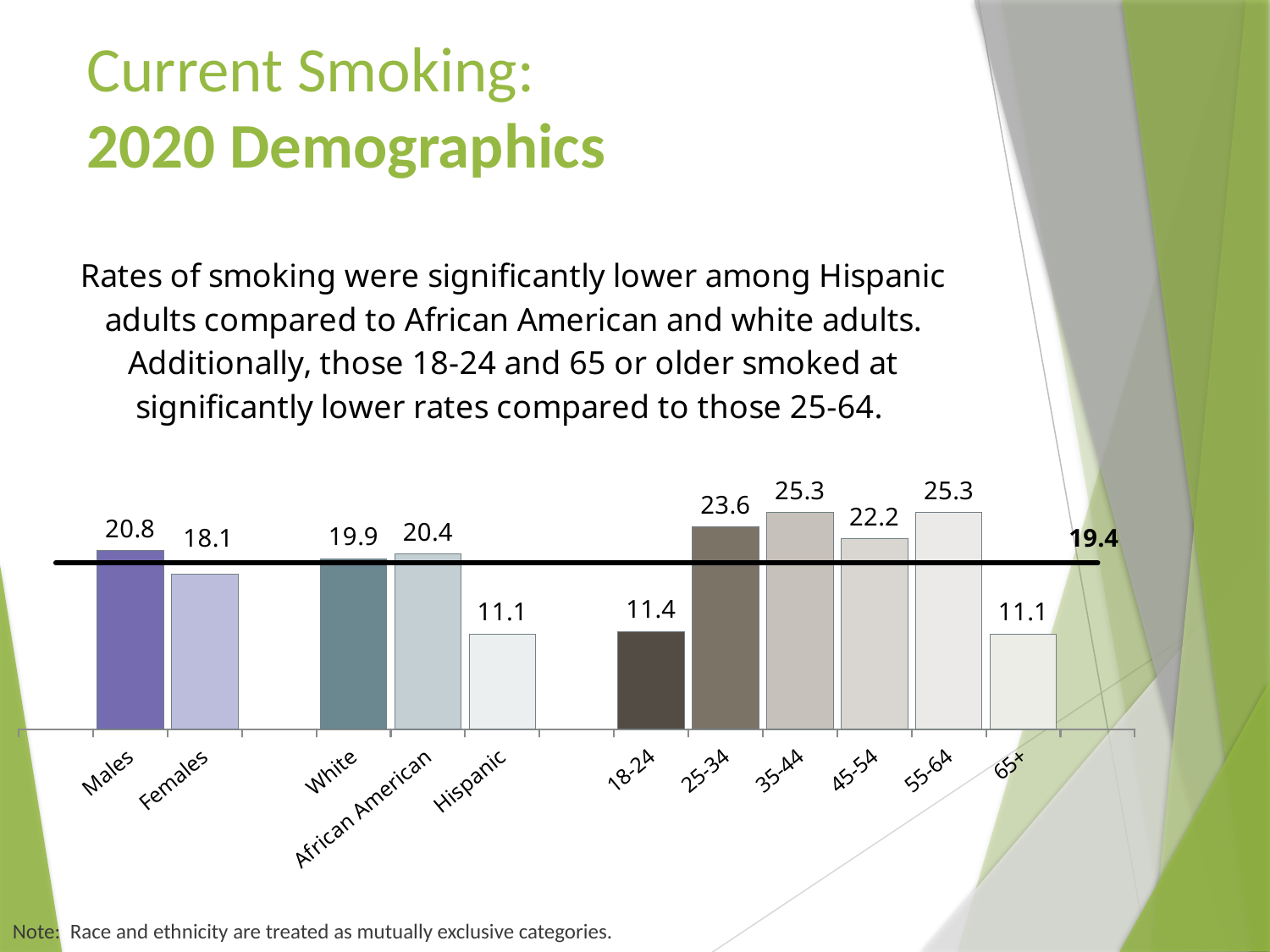
What is the value for Hispanic? 11.1 What is the value for Males? 20.8 What kind of chart is shown on the slide? Bar chart What value is labelled on the horizontal reference line across the chart? 19.4 Which is larger, the value for 25-34 or the value for 45-54? 25-34 What is the value for the 45-54 age group? 22.2 How many categories are shown on the x axis? 11 What is the difference between the values for the 25-34 and 18-24 age groups? 12.2 Which of the two gender categories has the lower value? Females What is the difference between the values for Males and Females? 2.7 Which of the race/ethnicity categories (White, African American, Hispanic) has the highest value? African American What is the value for the 18-24 age group? 11.4